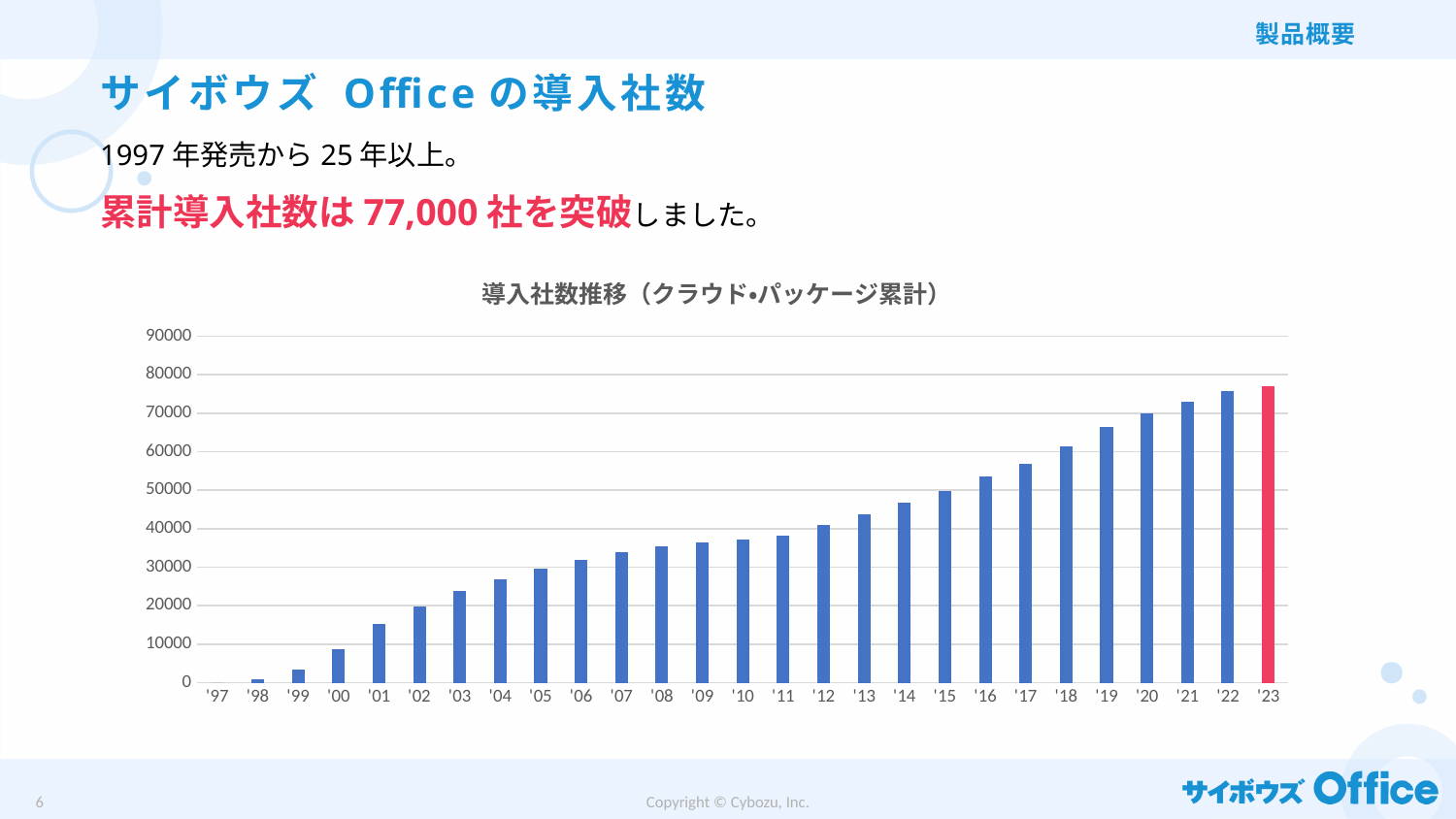
Which year has the larger value, '00 or '02? '02 Is the value for '03 greater or less than 30000? less Which year has the highest bar in the chart? '23 Which bar is shown in a different colour (red) from the others? '23 Do the values rise or fall from '97 to '23? rise What is the title of the chart? 導入社数推移（クラウド•パッケージ累計） What kind of chart is shown on the slide? bar chart Is the value for '01 greater or less than 10000? greater Is the value for '23 greater or less than 70000? greater Which year has the lowest bar in the chart? '97 How many years are plotted on the x axis of the chart? 27